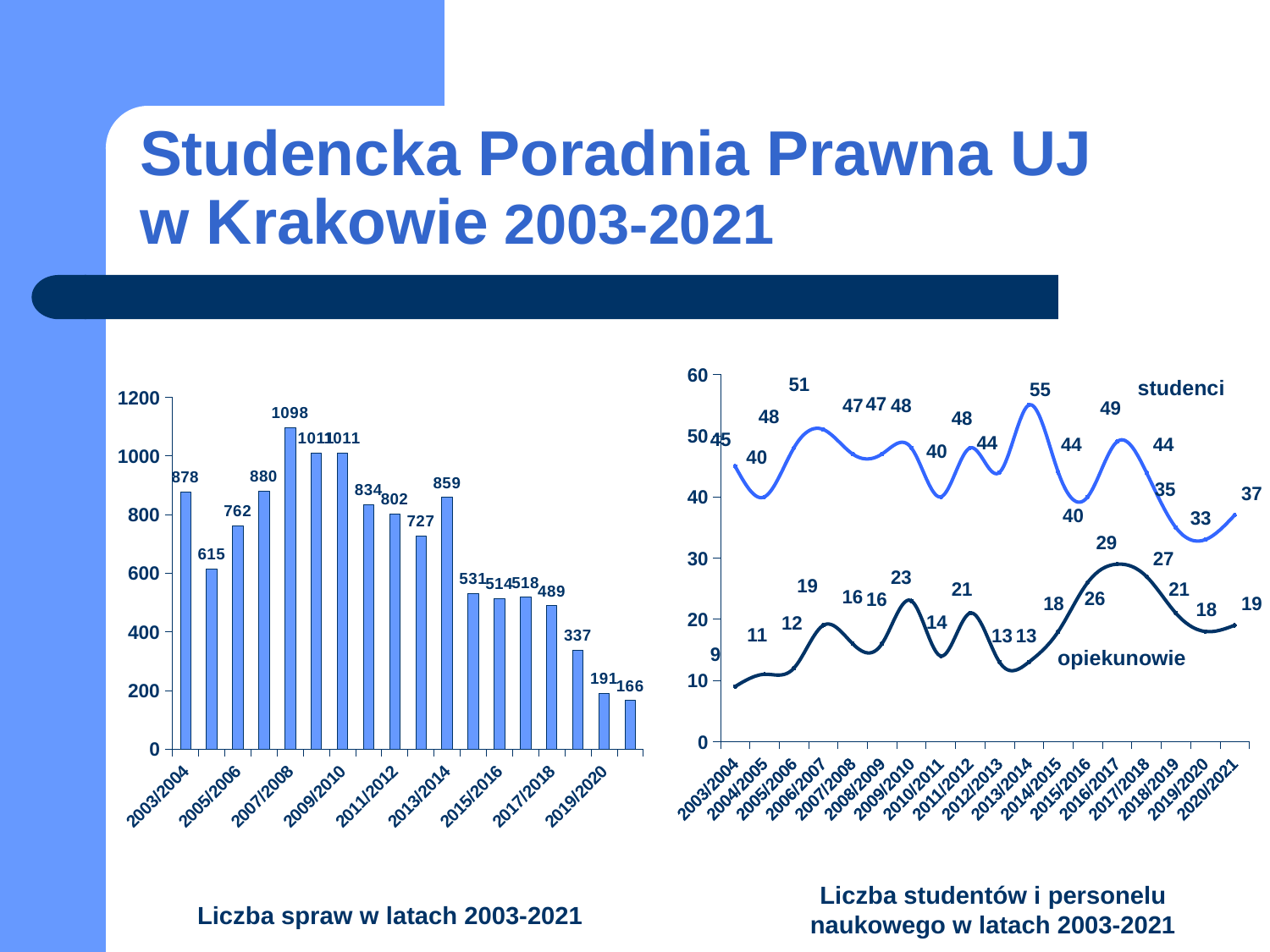
In the left chart 'Liczba spraw w latach 2003-2021', what is the value for 2007/2008? 1098 In the left chart 'Liczba spraw w latach 2003-2021', what is the lowest value shown? 166 In the left chart 'Liczba spraw w latach 2003-2021', which is larger: the value for 2011/2012 or for 2013/2014? 2013/2014 In the right chart 'Liczba studentów i personelu naukowego w latach 2003-2021', what is the difference between studenci and opiekunowie in 2003/2004? 36 How many bars are plotted in the left chart 'Liczba spraw w latach 2003-2021'? 18 In the right chart 'Liczba studentów i personelu naukowego w latach 2003-2021', what is the value for studenci in 2013/2014? 55 In the left chart 'Liczba spraw w latach 2003-2021', do the values rise or fall from 2013/2014 to 2019/2020? fall How many series are shown in the right chart 'Liczba studentów i personelu naukowego w latach 2003-2021'? 2 What kind of chart is the left chart, 'Liczba spraw w latach 2003-2021'? bar chart In the left chart 'Liczba spraw w latach 2003-2021', which year has the highest number of cases? 2007/2008 In the left chart 'Liczba spraw w latach 2003-2021', what is the difference between the values for 2003/2004 and 2005/2006? 116 In the right chart 'Liczba studentów i personelu naukowego w latach 2003-2021', in which year does the opiekunowie series reach its highest value? 2016/2017